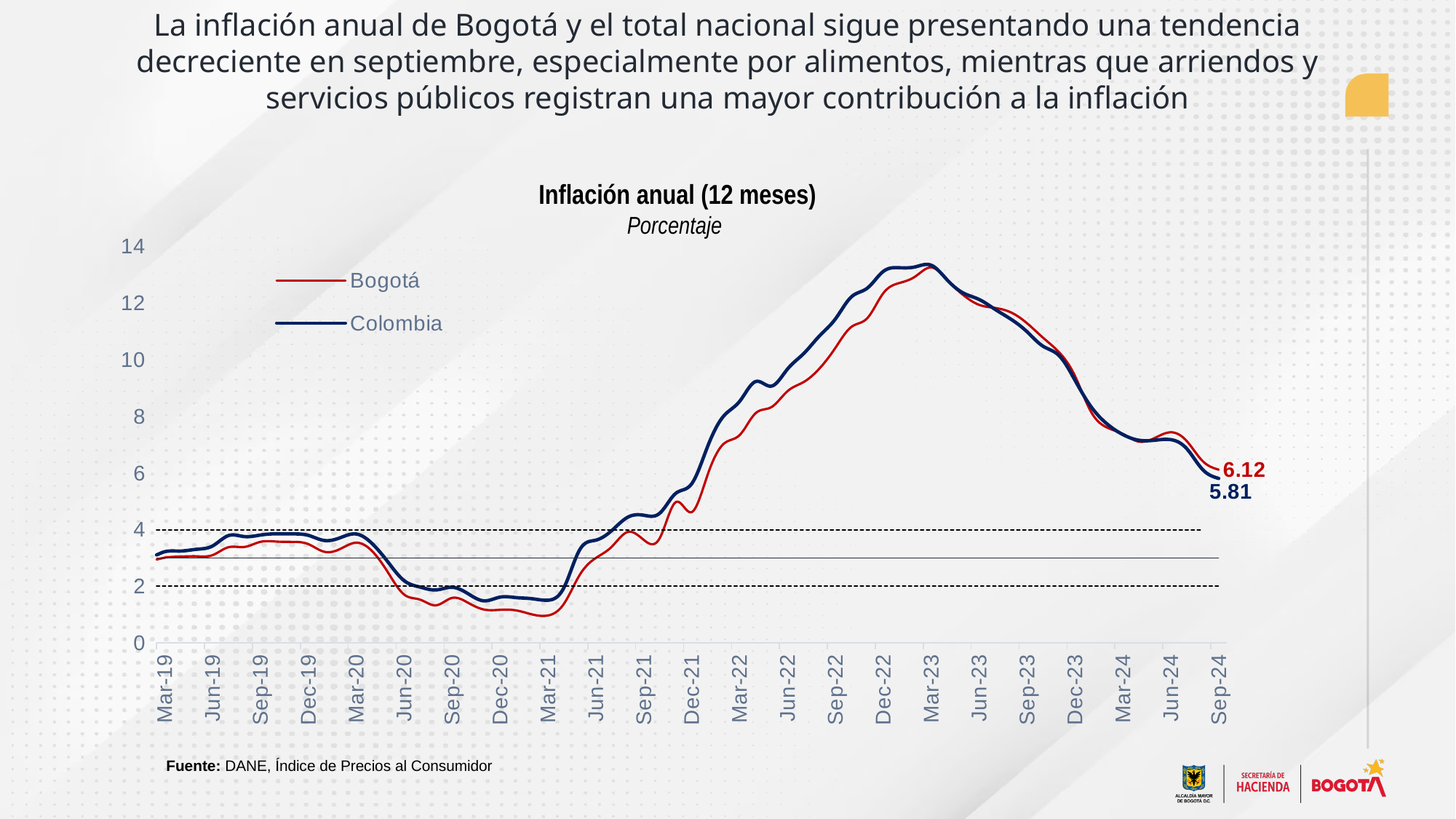
What kind of chart is shown on the slide? Line chart What is the value for Colombia at Sep-24? 5.81 Is the value for Colombia at Mar-23 greater or less than 12? greater How many labelled points are there on the x axis? 23 At Mar-22, which series has the higher value, Bogotá or Colombia? Colombia What is the value for Bogotá at Sep-24? 6.12 At Sep-24, which series has the higher value, Bogotá or Colombia? Bogotá Is the value for Bogotá at Dec-20 greater or less than 2? less What is the title of the chart? Inflación anual (12 meses) Do the values for Colombia rise or fall from Mar-23 to Sep-24? fall What is the difference between the Bogotá and Colombia values at Sep-24? 0.31 How many series does the legend list? 2